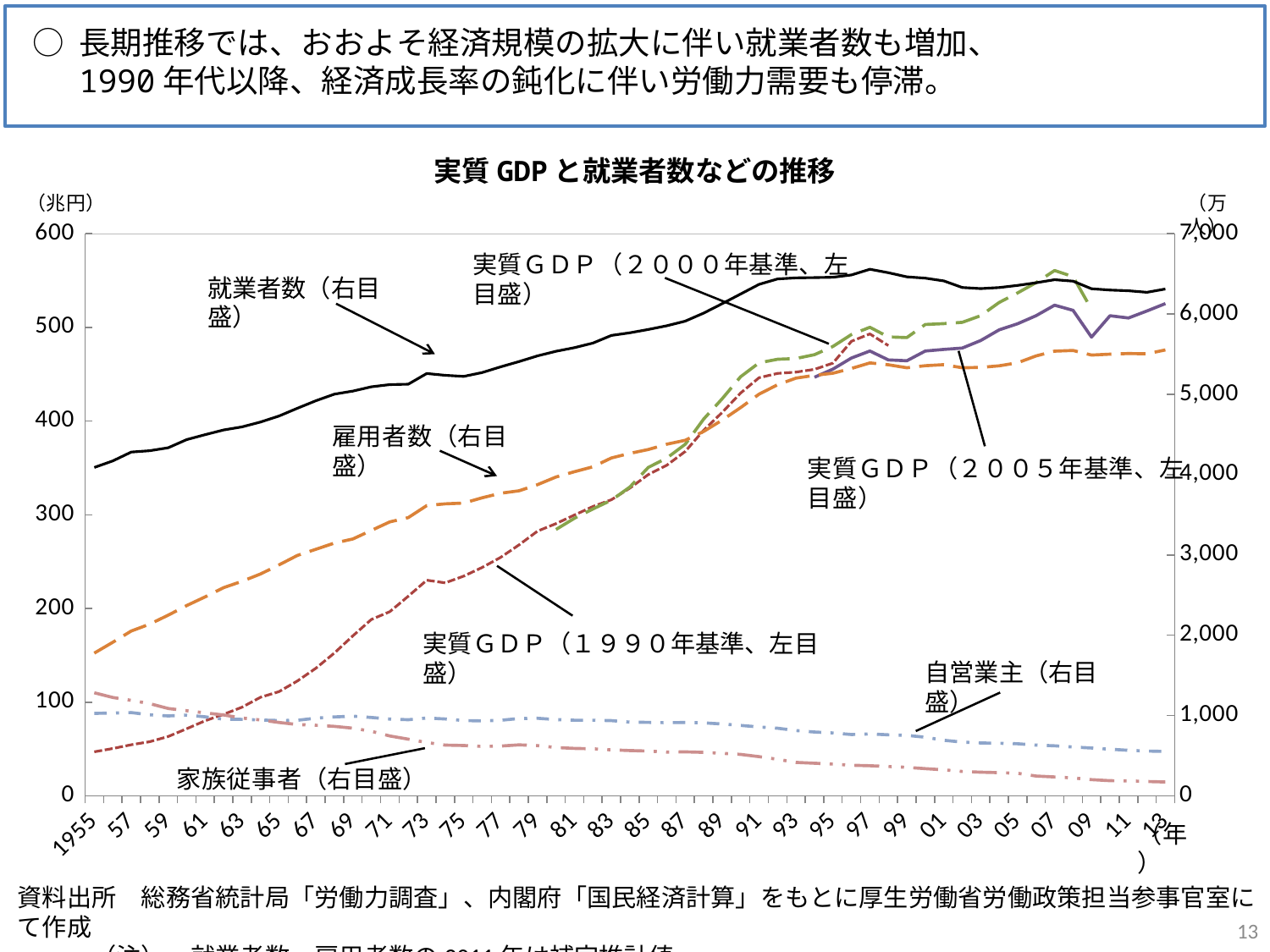
How many data series are labelled on the chart? 7 Does the 家族従事者 (右目盛) series rise or fall from 1955 to 2013? fall In 2013, which is larger: 自営業主 (右目盛) or 家族従事者 (右目盛)? 自営業主 (右目盛) Is the value for 実質GDP (1990年基準、左目盛) in 1955 greater or less than 100? less What unit is shown on the left vertical axis of the chart? 兆円 In 1955, which is larger: 就業者数 (右目盛) or 雇用者数 (右目盛)? 就業者数 (右目盛) What kind of chart is shown on the slide? line chart Is the value for 雇用者数 (右目盛) in 1955 greater or less than 2,000? less Is the value for 自営業主 (右目盛) in 2013 greater or less than 1,000? less Does the 雇用者数 (右目盛) series generally rise or fall from 1955 to 2013? rise What is the title of the chart? 実質GDPと就業者数などの推移